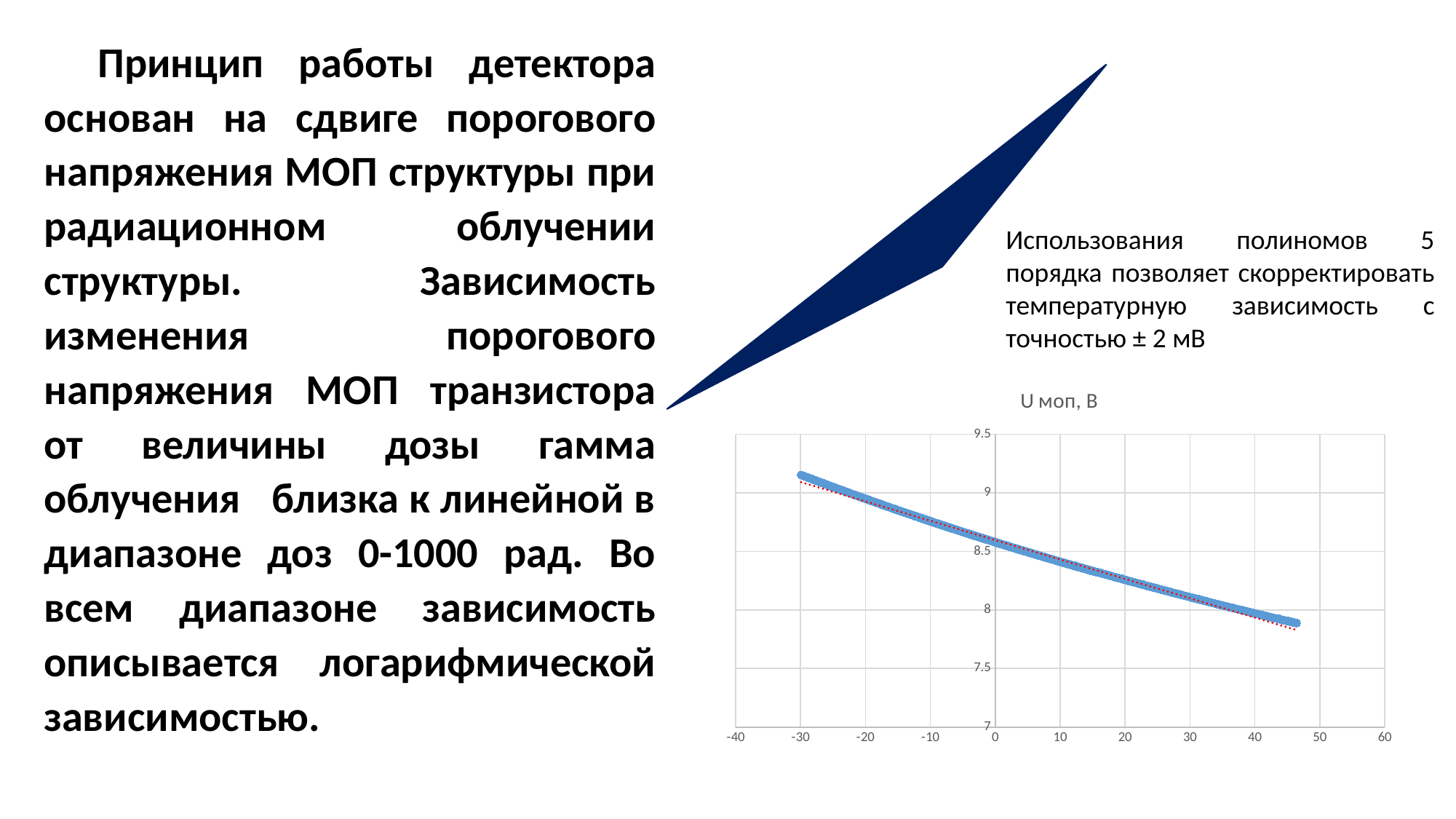
What is the title of the chart? U моп, В At which end of the x axis range, -30 or 45, is the plotted value lowest? 45 Is the value at x = 40 greater or less than 8.5? less Is the value at x = 45 greater or less than 8? less Do the plotted values rise or fall as the x value increases? fall What kind of chart is shown on the slide? scatter chart Which is larger: the value at x = -30 or the value at x = 40? the value at x = -30 Is the value at x = -10 greater or less than 8.5? greater At which end of the x axis range, -30 or 45, is the plotted value highest? -30 What is the highest value shown on the y axis? 9.5